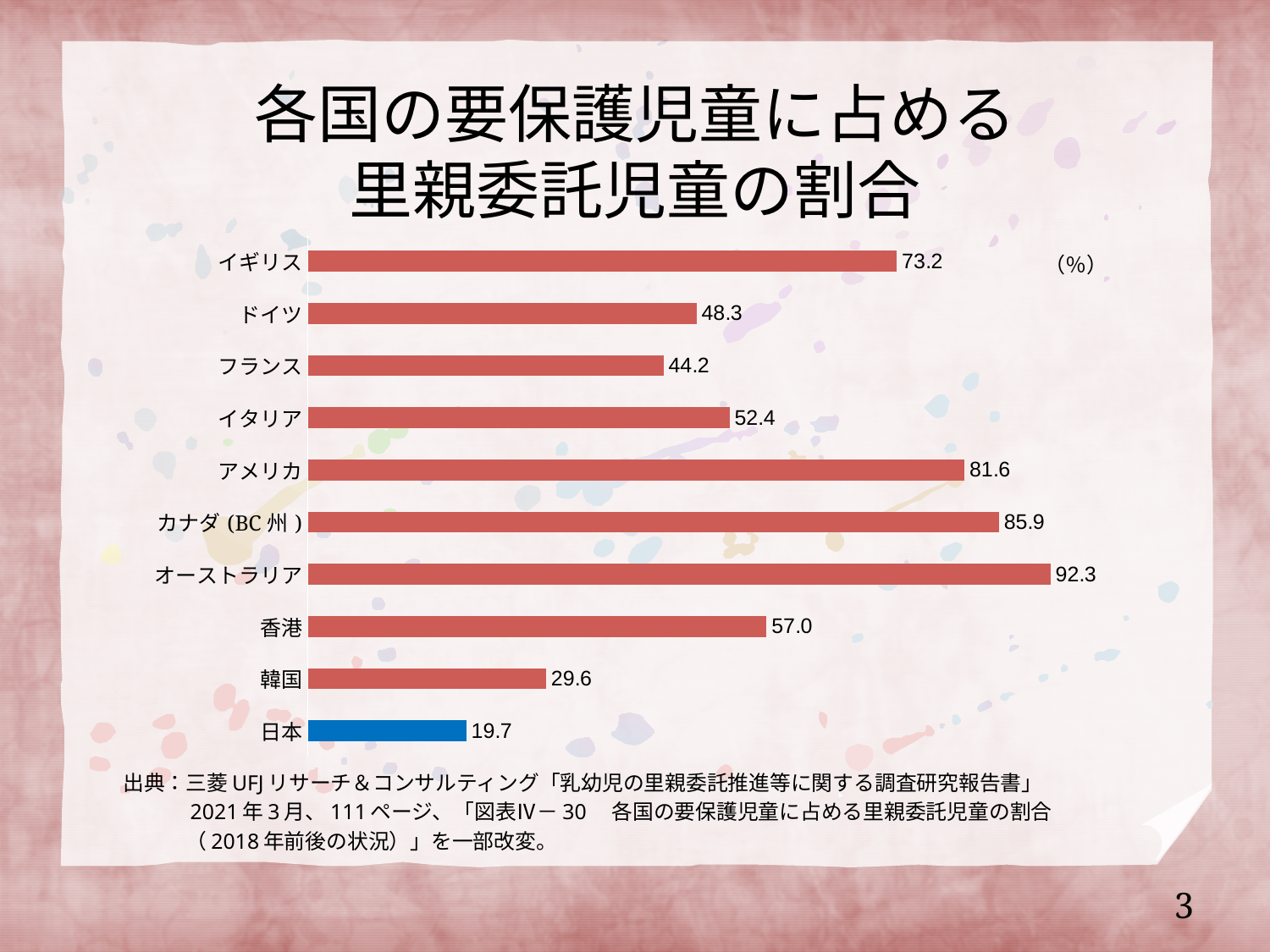
What is the value for イギリス? 73.2 What is the value for カナダ (BC州)? 85.9 What kind of chart is shown on the slide? bar chart Which country has the lowest value? 日本 Which bar is shown in a different colour (blue) from the others? 日本 What is the difference between the values for アメリカ and ドイツ? 33.3 Which country has the highest value? オーストラリア What is the value for 日本? 19.7 Which is larger, the value for 香港 or the value for 韓国? 香港 How many countries or regions are shown in the chart? 10 What is the difference between the values for オーストラリア and 日本? 72.6 Which is larger, the value for イタリア or the value for フランス? イタリア